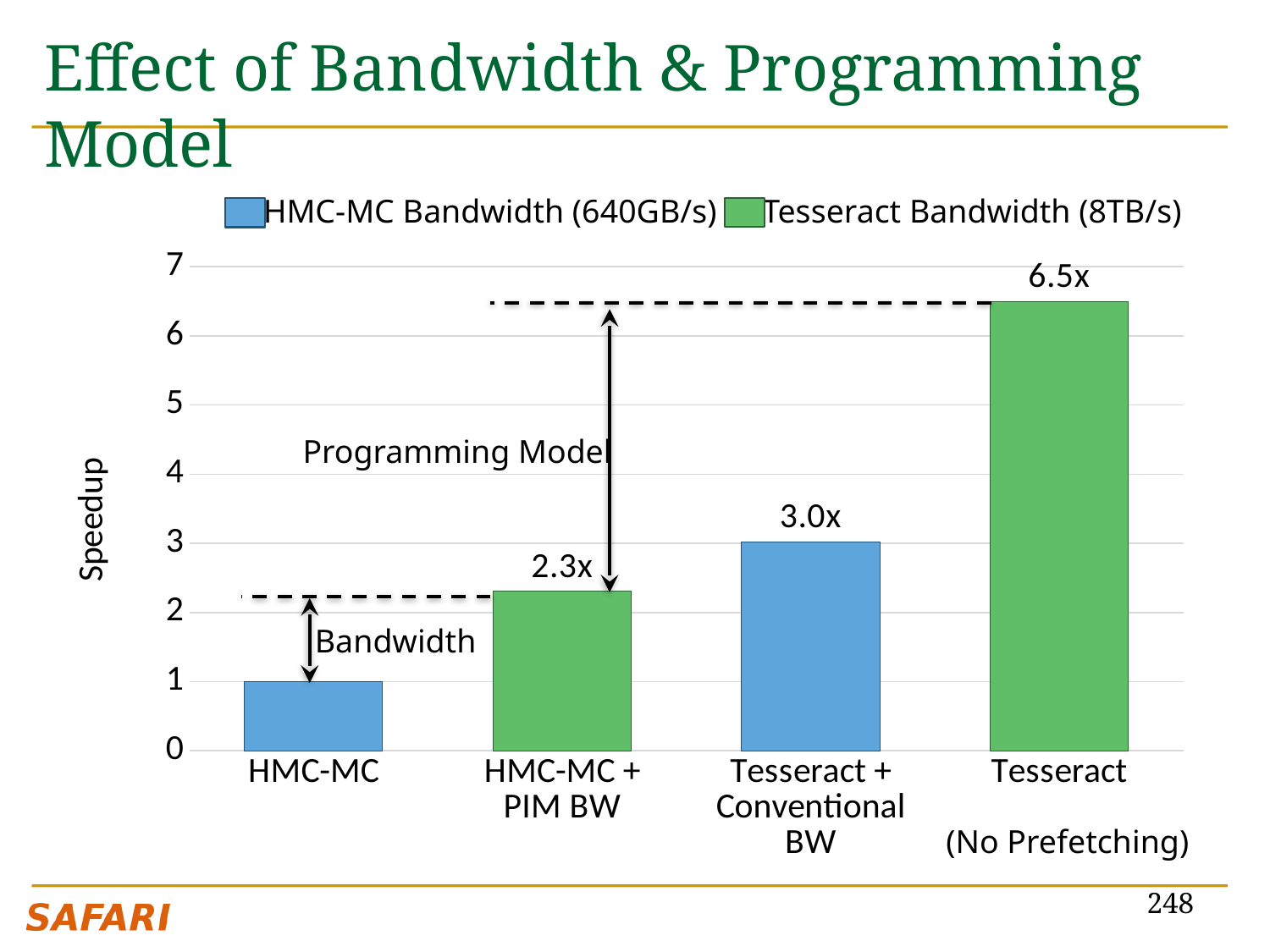
Is the speedup for HMC-MC greater or less than 2? less Which category has the lowest speedup? HMC-MC How many series does the legend list? 2 Which has a larger speedup, Tesseract + Conventional BW or HMC-MC + PIM BW? Tesseract + Conventional BW What is the speedup shown for Tesseract (No Prefetching)? 6.5x What kind of chart is shown on the slide? bar chart What is the difference in speedup between Tesseract (No Prefetching) and HMC-MC + PIM BW? 4.2x Which category has the highest speedup? Tesseract (No Prefetching) What is the difference in speedup between Tesseract + Conventional BW and HMC-MC + PIM BW? 0.7x What is the speedup shown for HMC-MC + PIM BW? 2.3x What is the speedup shown for Tesseract + Conventional BW? 3.0x How many categories are shown on the x axis? 4